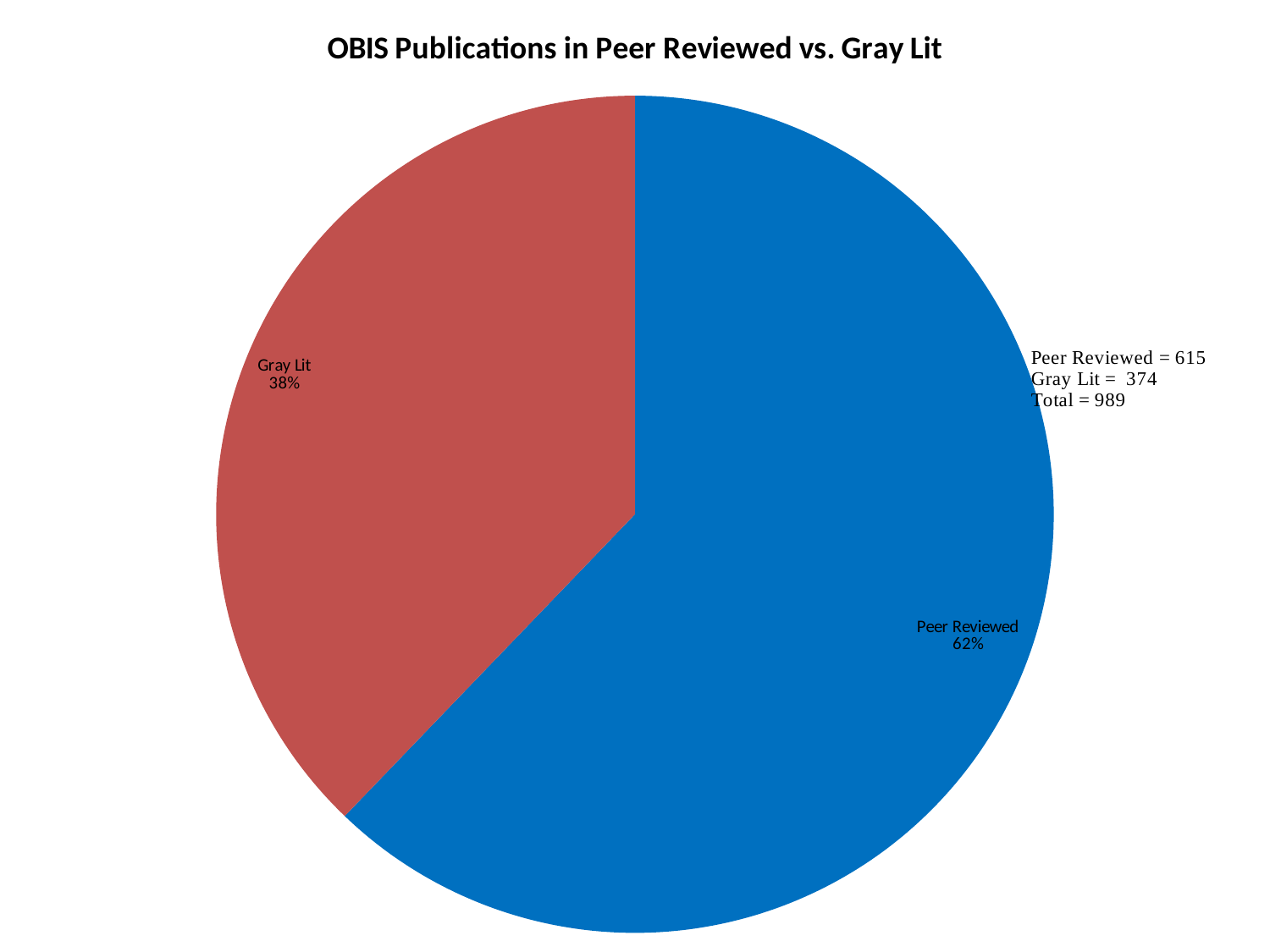
What is the difference in percentage points between the Peer Reviewed and Gray Lit slices? 24% How many slices does the pie chart have? 2 What is the title of the chart? OBIS Publications in Peer Reviewed vs. Gray Lit Which slice is the largest? Peer Reviewed What share of the pie does Gray Lit represent? 38% What share of the pie does Peer Reviewed represent? 62% How many more Peer Reviewed publications are there than Gray Lit publications? 241 Which slice is the smallest? Gray Lit How many Peer Reviewed publications are listed in the text annotation? 615 What kind of chart is shown on the slide? pie chart What is the total number of publications shown on the slide? 989 How many Gray Lit publications are listed in the text annotation? 374